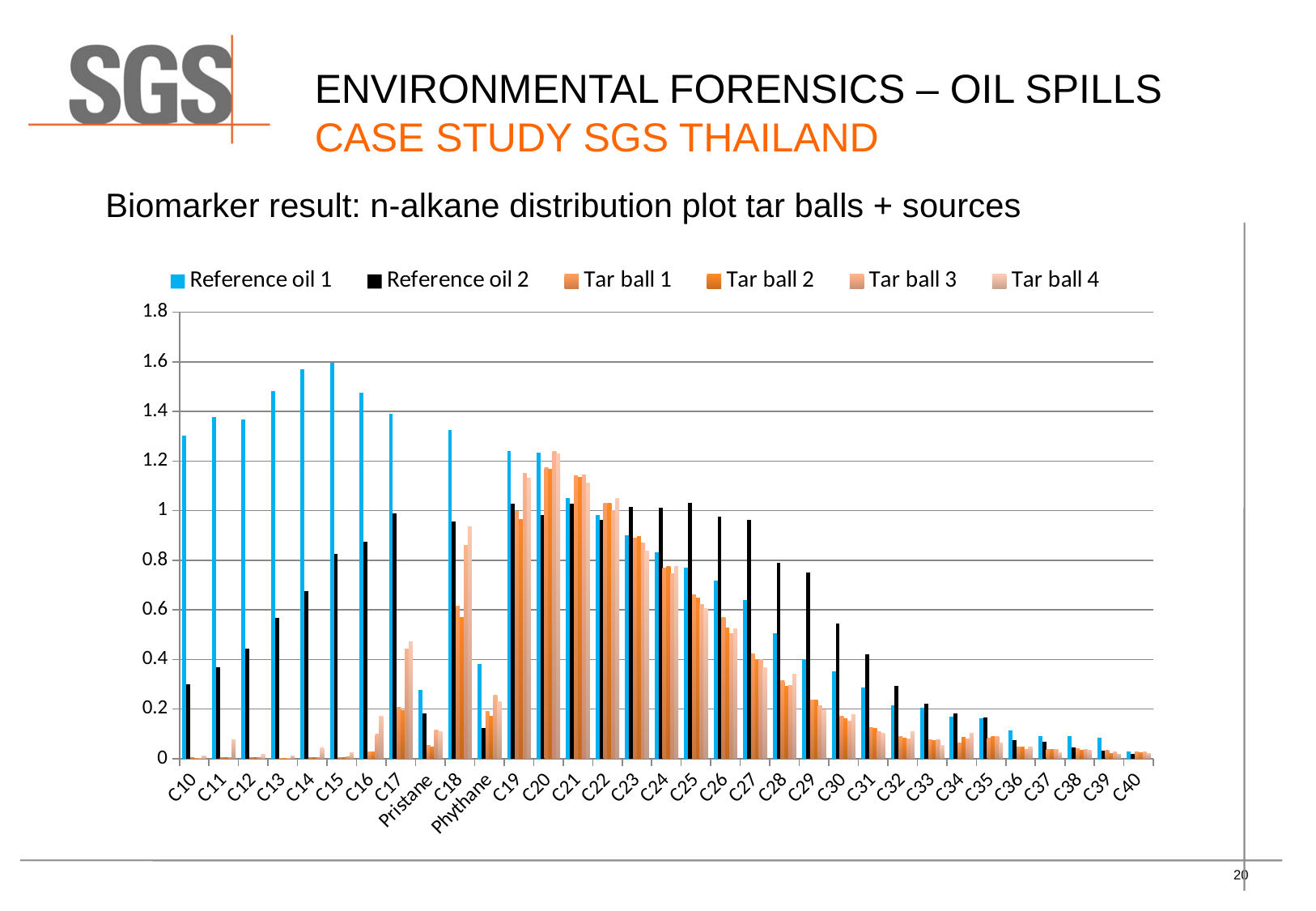
Which is larger at C27, Reference oil 1 or Reference oil 2? Reference oil 2 How many categories are shown along the x axis? 33 Which is larger at C12, Reference oil 1 or Reference oil 2? Reference oil 1 Is the value for Reference oil 1 at C18 greater or less than 1.2? greater Is the value for Reference oil 2 at C29 greater or less than 0.6? greater Is the value for Reference oil 2 at C10 greater or less than 0.2? greater Do the values for Reference oil 1 rise or fall from C19 to C40? fall How many series does the legend list? 6 What kind of chart is shown on the slide? bar chart What colour represents Reference oil 2 in the legend? black